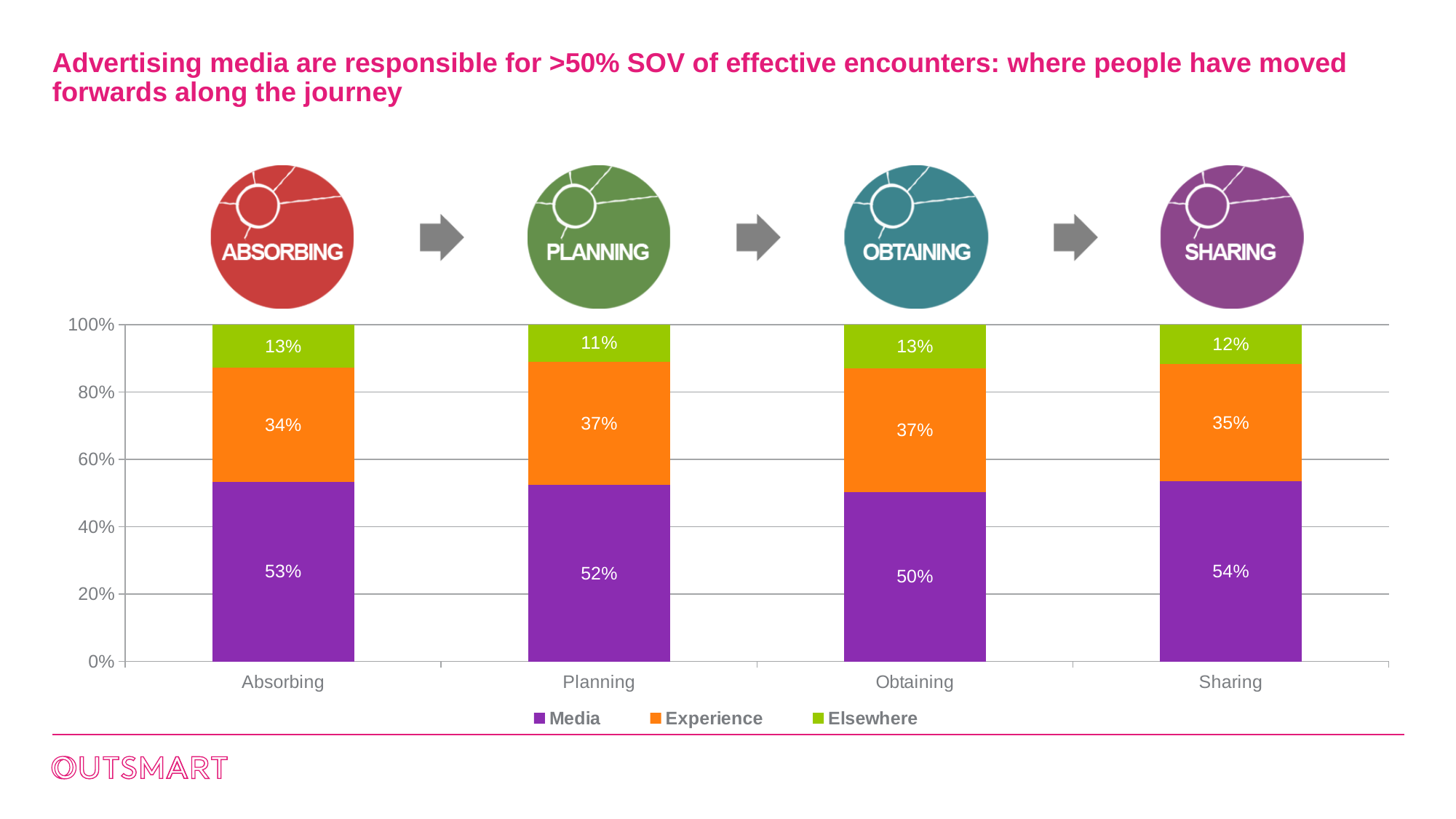
How many series does the legend list? 3 What kind of chart is shown on the slide? Stacked bar chart What is the total of the stacked bar for Absorbing? 100% Which category has the lowest Elsewhere value? Planning What is the Media value for Obtaining? 50% What is the difference between the Media values for Sharing and Obtaining? 4% Which category has the highest Media value? Sharing Which is larger, the Experience value for Absorbing or the Experience value for Planning? Planning What is the Elsewhere value for Sharing? 12% What is the Experience value for Planning? 37% How many categories are shown on the x axis? 4 Which colour represents the Experience series in the legend? Orange